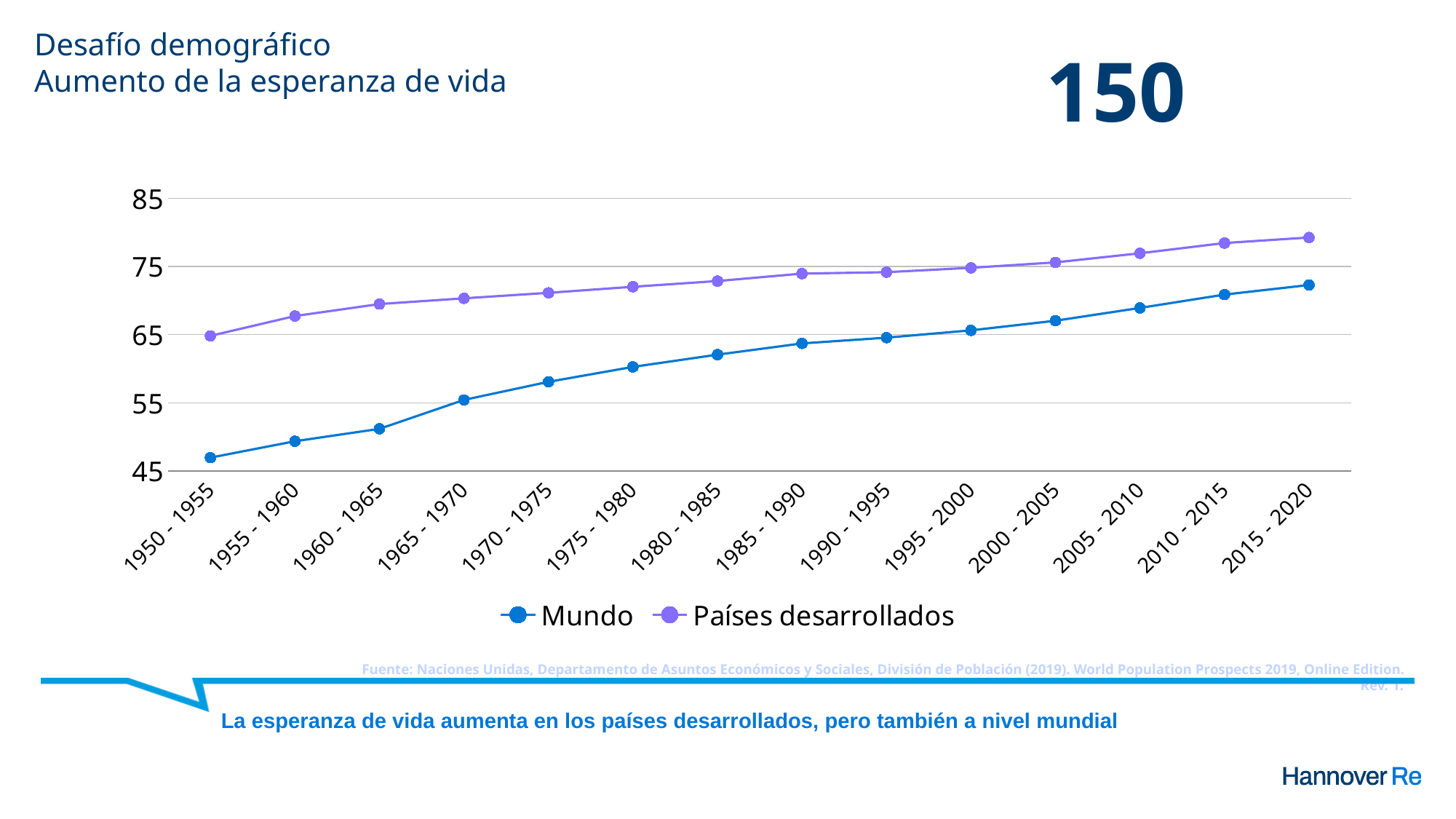
Which is larger in 1950 - 1955, the value for Mundo or for Países desarrollados? Países desarrollados Do the values for Países desarrollados rise or fall across the periods shown? rise Is the value for Países desarrollados in 2015 - 2020 greater or less than 75? greater What kind of chart is shown on the slide? line chart How many series does the legend list? 2 Is the value for Mundo in 1950 - 1955 greater or less than 55? less Which series is plotted in purple? Países desarrollados How many time periods are shown on the x axis? 14 In which period is the value for Mundo highest? 2015 - 2020 In which period is the value for Mundo lowest? 1950 - 1955 Do the values for Mundo rise or fall from 1950 - 1955 to 2015 - 2020? rise Is the value for Mundo in 2015 - 2020 greater or less than 75? less